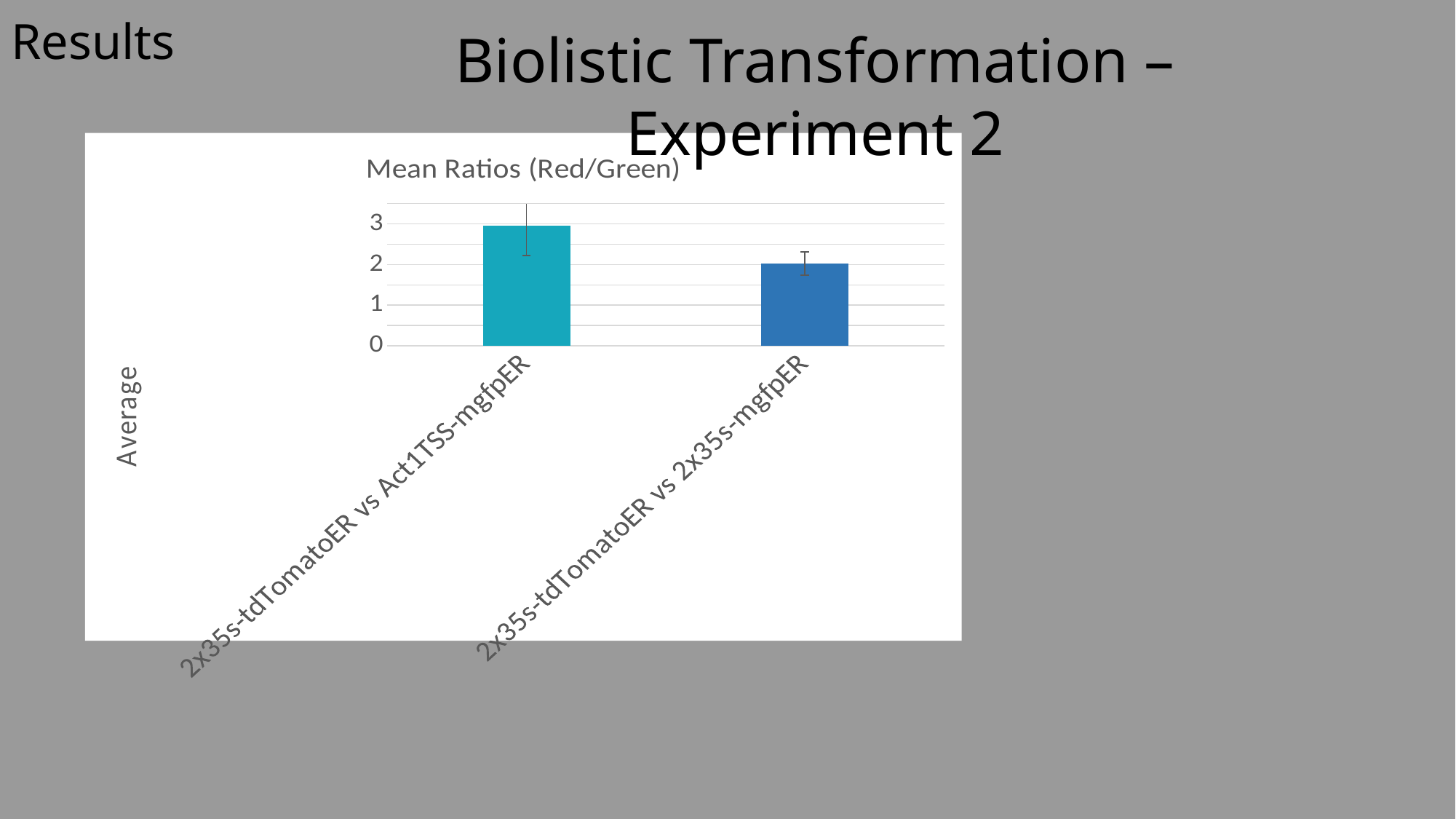
What is the label on the vertical axis of the chart? Average Is the value for 2x35s-tdTomatoER vs Act1TSS-mgfpER greater or less than 2? greater What type of chart is shown on the slide? bar chart Which is larger, the value for 2x35s-tdTomatoER vs Act1TSS-mgfpER or the value for 2x35s-tdTomatoER vs 2x35s-mgfpER? 2x35s-tdTomatoER vs Act1TSS-mgfpER Do the bar values rise or fall from left to right along the x axis? fall What is the title of the chart? Mean Ratios (Red/Green) Which category has the highest mean ratio? 2x35s-tdTomatoER vs Act1TSS-mgfpER Which category has the lowest mean ratio? 2x35s-tdTomatoER vs 2x35s-mgfpER Is the value for 2x35s-tdTomatoER vs 2x35s-mgfpER greater or less than 3? less How many categories are plotted in the chart? 2 Is the value for 2x35s-tdTomatoER vs 2x35s-mgfpER greater or less than 1? greater